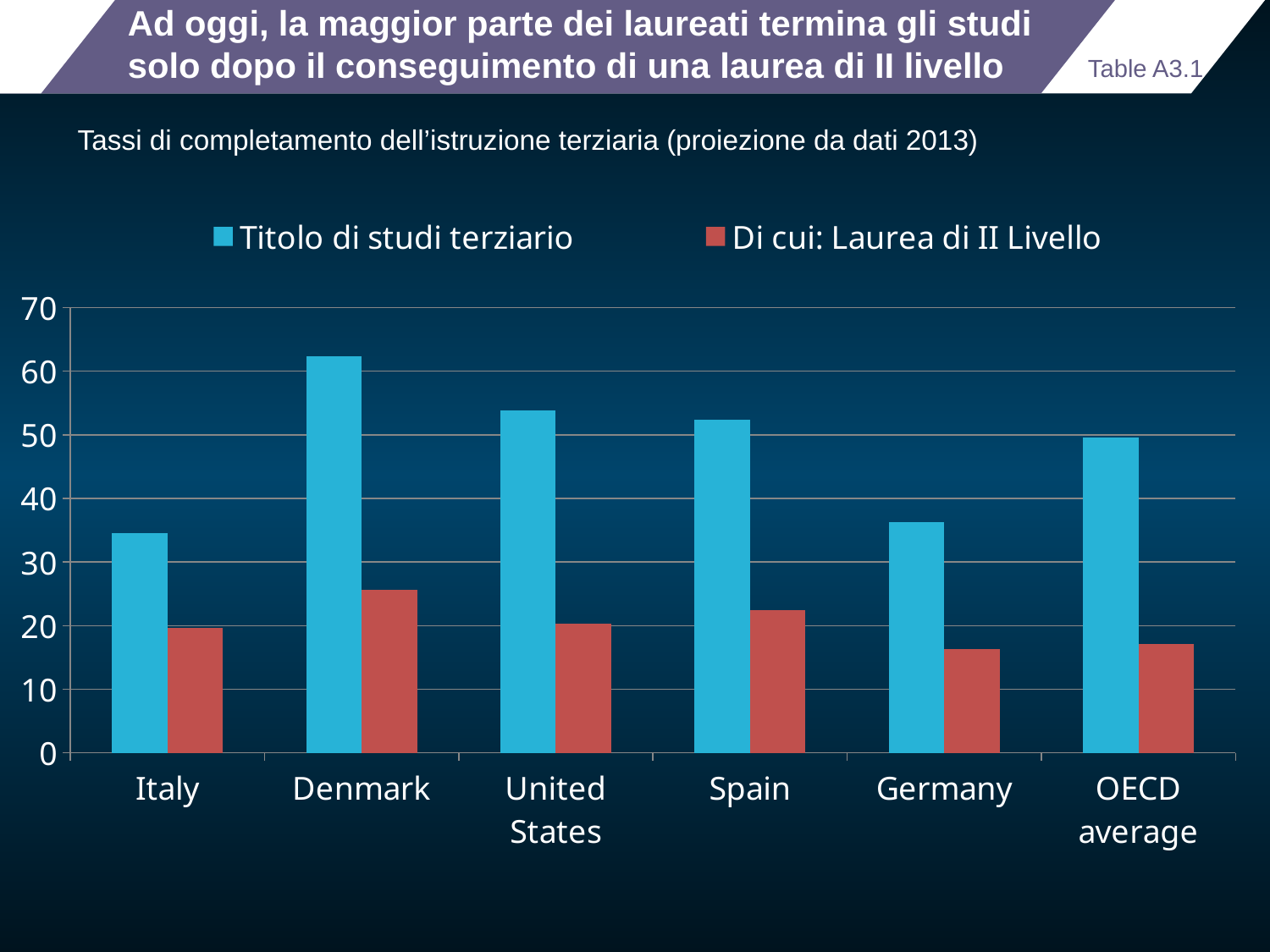
What kind of chart is shown on the slide? bar chart Is the value for 'Titolo di studi terziario' in Italy greater or less than 30? greater Is the value for 'Titolo di studi terziario' in Denmark greater or less than 60? greater How many series does the legend list? 2 Which is larger for 'Di cui: Laurea di II Livello': Spain or Germany? Spain What colour are the bars for 'Di cui: Laurea di II Livello'? red Which is larger for 'Titolo di studi terziario': United States or Germany? United States Is the value for 'Di cui: Laurea di II Livello' in Germany greater or less than 20? less Which category has the highest value for 'Titolo di studi terziario'? Denmark Which category has the highest value for 'Di cui: Laurea di II Livello'? Denmark How many countries or categories are shown on the x axis? 6